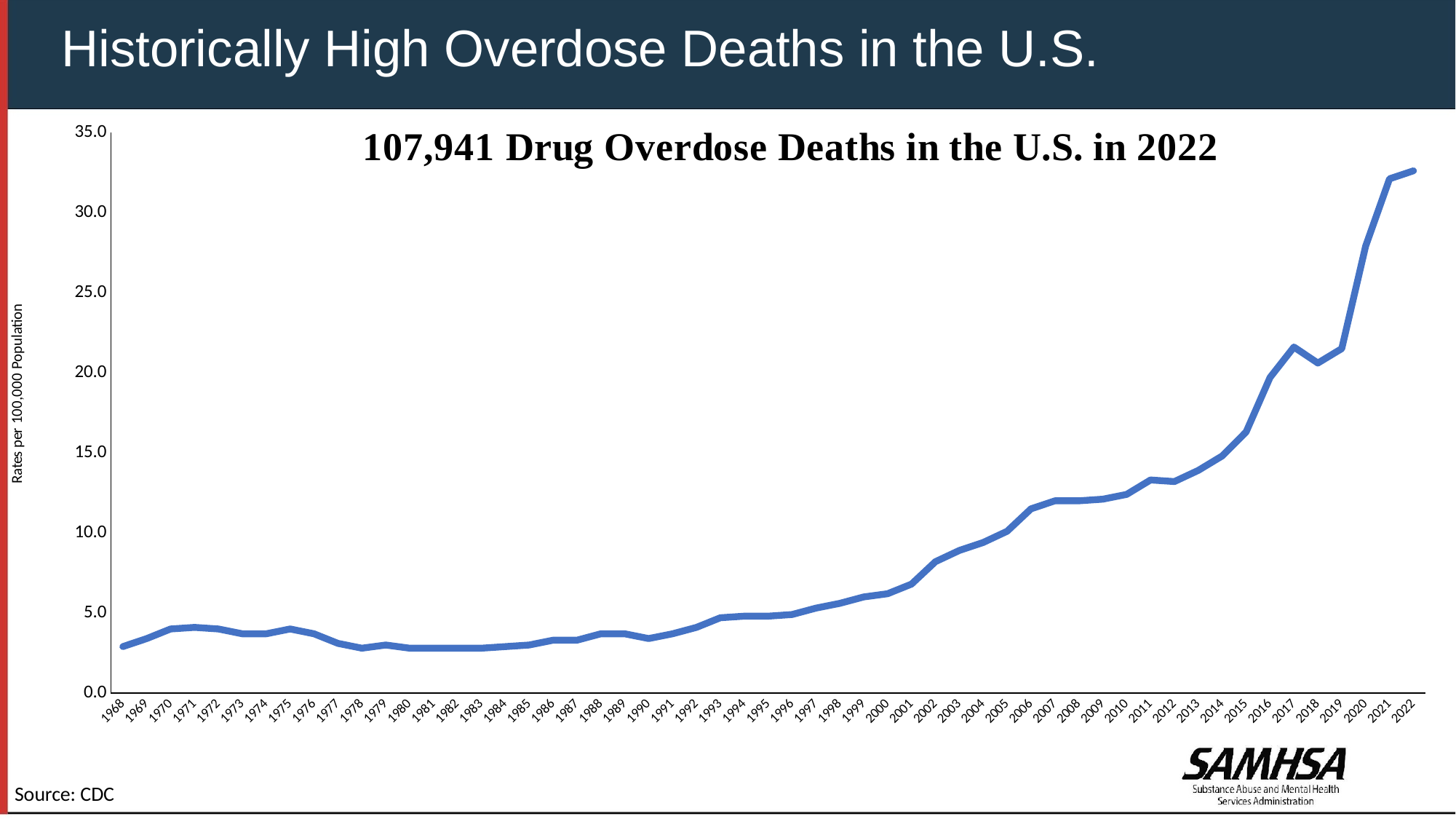
Which year has the highest overdose death rate in the chart? 2022 Is the value for 2022 greater or less than 30? greater What is the label on the vertical axis of the chart? Rates per 100,000 Population Is the value for 2017 greater or less than 20? greater What kind of chart is shown on the slide? Line chart Which year has the higher overdose death rate, 2017 or 2018? 2017 Is the value for 2000 greater or less than 10? less Overall, does the overdose death rate rise or fall from 1968 to 2022? Rise How many years are plotted along the x axis of the chart? 55 What is the title of the chart? 107,941 Drug Overdose Deaths in the U.S. in 2022